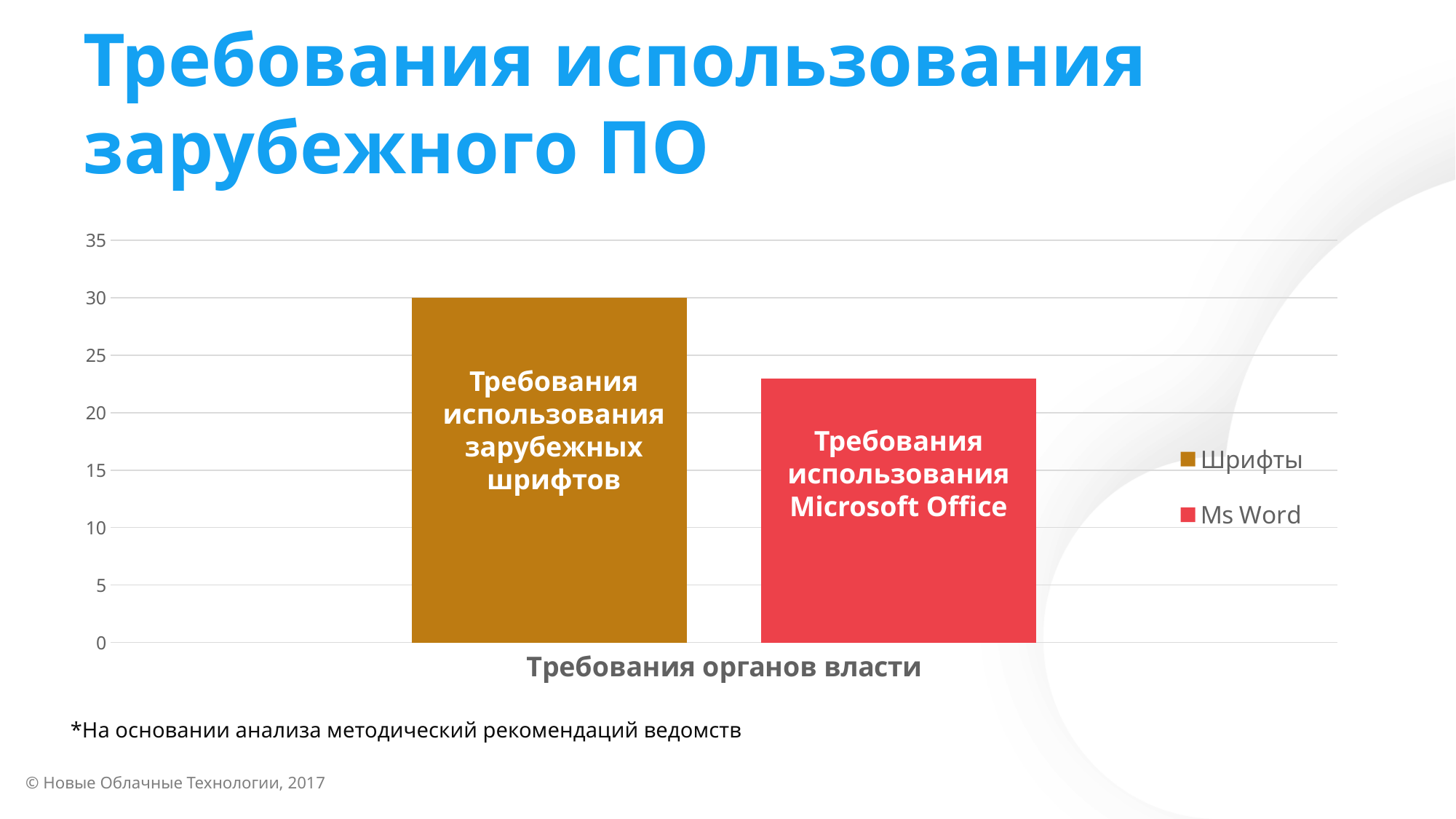
Is the value for Ms Word greater or less than 25? less What is the category label shown on the x axis? Требования органов власти Is the value for Ms Word greater or less than 20? greater Which series has the highest bar? Шрифты How many bars are plotted in the chart? 2 Is the value for Шрифты greater or less than 25? greater Which series has the higher value, Шрифты or Ms Word? Шрифты What kind of chart is shown on the slide? bar chart Which series has the lowest bar? Ms Word What are the two series listed in the legend? Шрифты and Ms Word How many series does the legend list? 2 What is the value of the Шрифты bar? 30